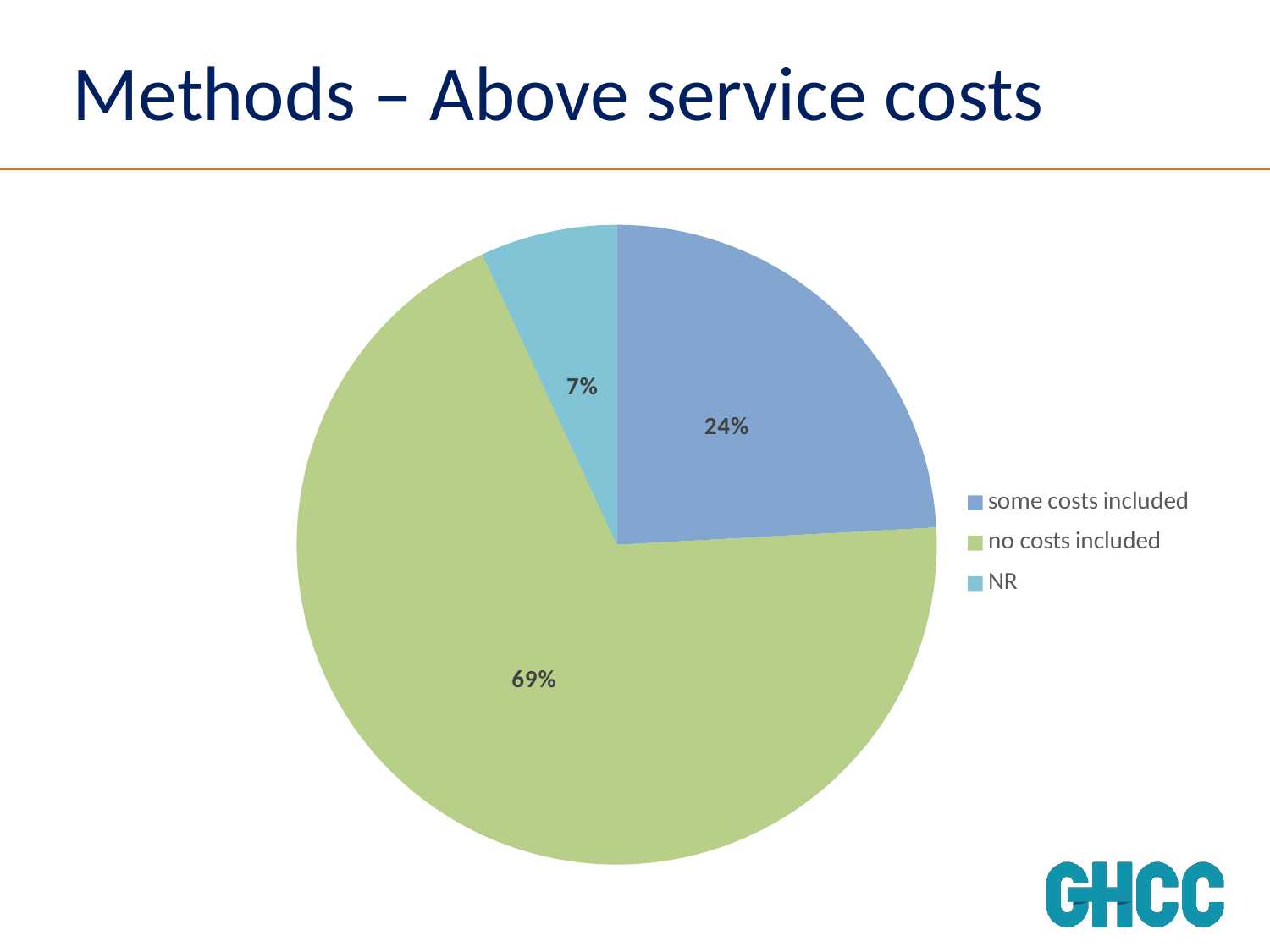
What is the difference in percentage points between "no costs included" and "some costs included"? 45 What share of the pie is labelled "NR"? 7% Which is larger, the slice for "some costs included" or the slice for "NR"? some costs included Which category has the largest slice of the pie? no costs included What colour is the slice for "no costs included"? green How many slices does the pie chart have? 3 What is the title of the slide containing the chart? Methods – Above service costs What share of the pie is labelled "some costs included"? 24% What share of the pie is labelled "no costs included"? 69% What is the difference in percentage points between "some costs included" and "NR"? 17 What kind of chart is shown on the slide? pie chart Which category has the smallest slice of the pie? NR